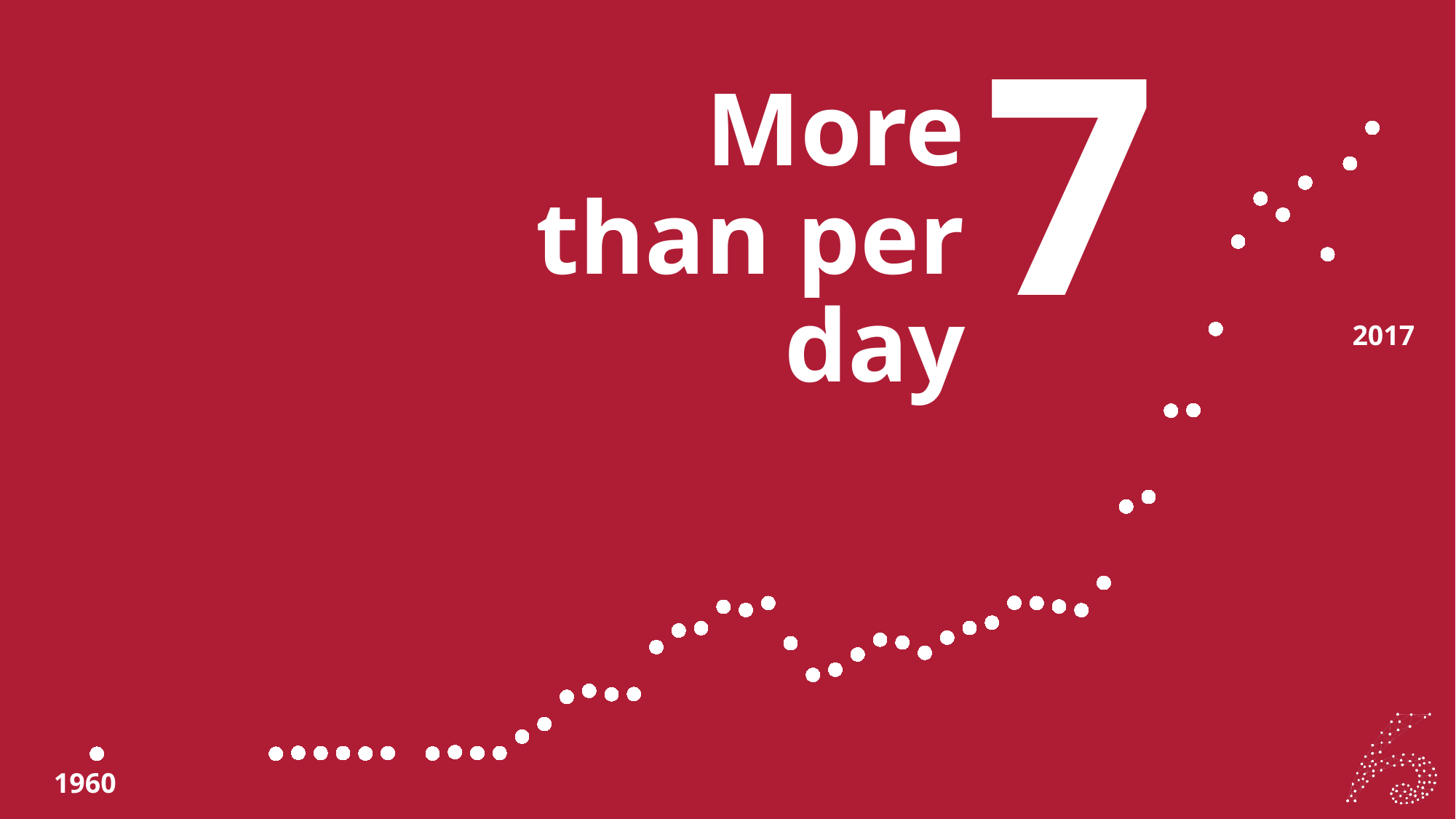
Do the plotted values generally rise or fall from 1960 to 2017? rise Which year is labelled at the end of the dotted series? 2017 Which year is labelled at the start of the dotted series? 1960 What kind of chart is shown on the slide? scatter chart Which year has the higher plotted value, 1960 or 2017? 2017